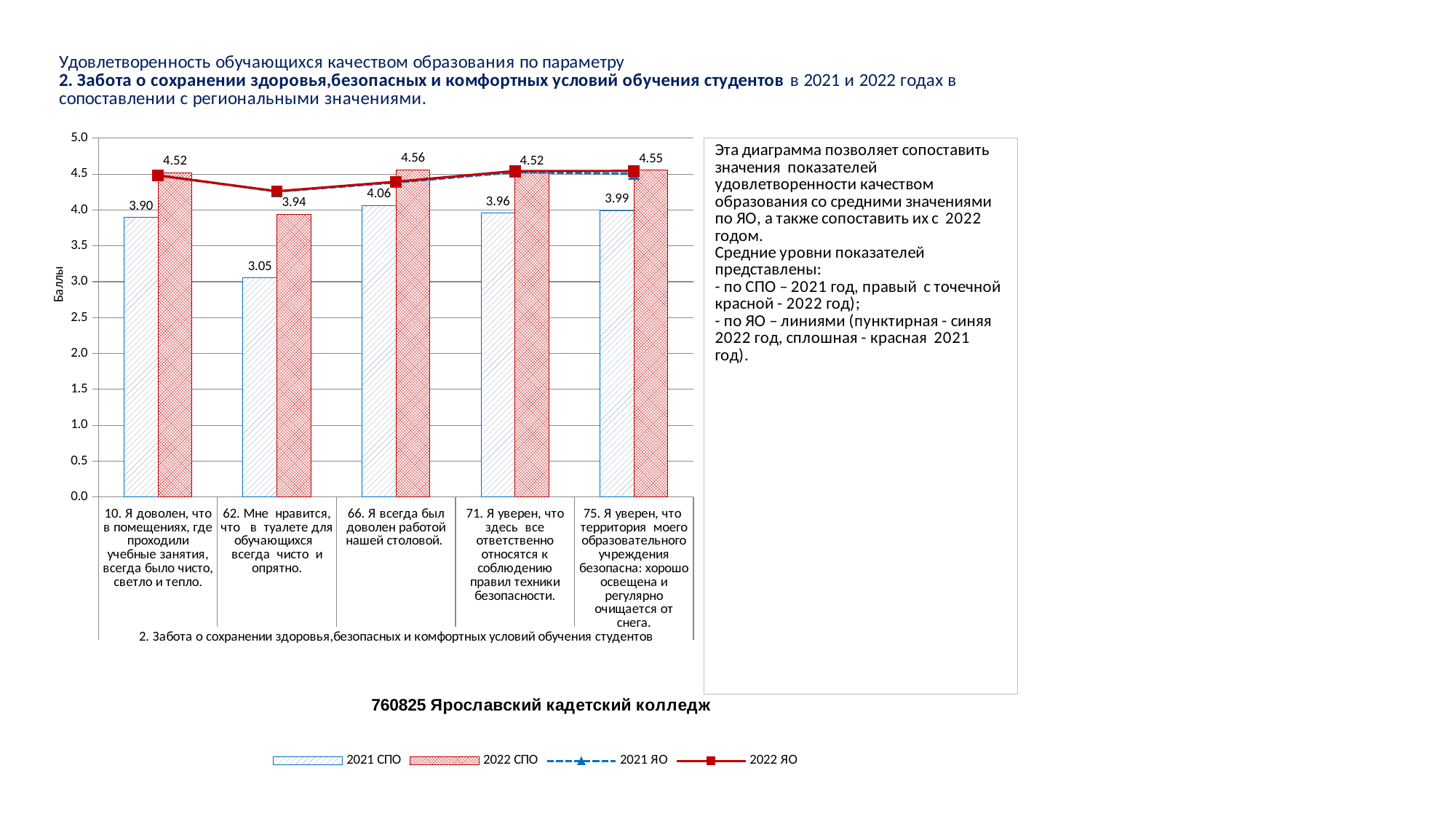
How many questions (categories) are shown on the x axis? 5 What is the 2022 СПО value for question 10 ("Я доволен, что в помещениях, где проходили учебные занятия, всегда было чисто, светло и тепло")? 4.52 What is the 2022 СПО value for question 66 ("Я всегда был доволен работой нашей столовой")? 4.56 Which question has the highest 2022 СПО value? 66. Я всегда был доволен работой нашей столовой. What is the 2021 СПО value for question 62 ("Мне нравится, что в туалете для обучающихся всегда чисто и опрятно")? 3.05 What is the difference between the 2022 СПО and 2021 СПО values for question 75? 0.56 Which question has the lowest 2021 СПО value? 62. Мне нравится, что в туалете для обучающихся всегда чисто и опрятно. How many series does the legend list? 4 What is the difference between the 2022 СПО and 2021 СПО values for question 62? 0.89 Which is larger for question 71: the 2021 СПО value or the 2022 СПО value? 2022 СПО What is the label of the vertical axis? Баллы Is the 2021 СПО value for question 62 greater or less than 3.5? less